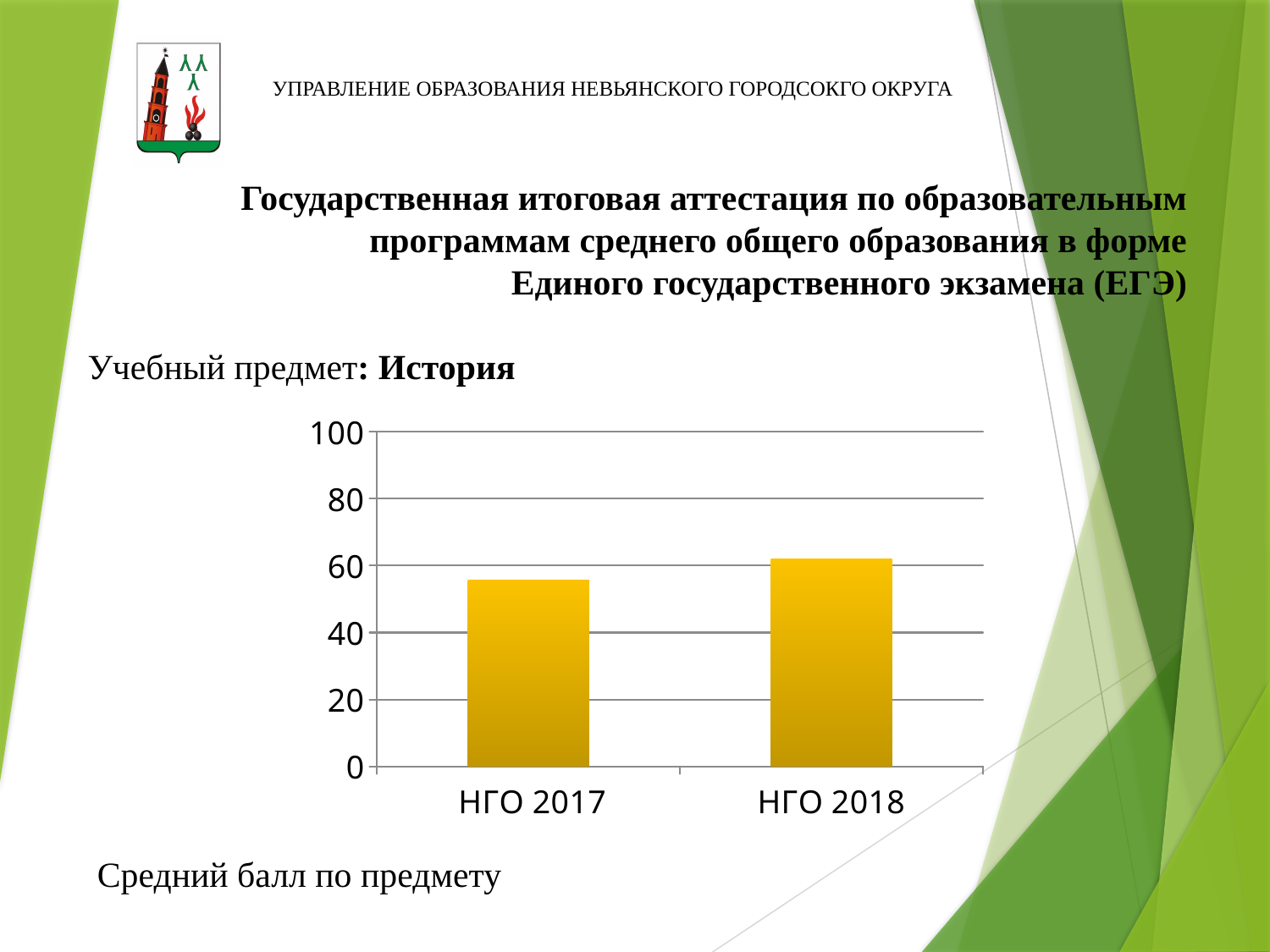
Is the value for НГО 2017 greater or less than 40? greater Do the values rise or fall from НГО 2017 to НГО 2018? rise How many bars (categories) does the chart show? 2 Which is larger, the value for НГО 2017 or the value for НГО 2018? НГО 2018 What is the maximum value shown on the vertical axis of the chart? 100 Which category has the lowest value in the chart? НГО 2017 Which category has the highest value in the chart? НГО 2018 Is the value for НГО 2017 greater or less than 60? less Is the value for НГО 2018 greater or less than 60? greater Which school subject (учебный предмет) does the chart refer to? История What kind of chart is shown on the slide? bar chart